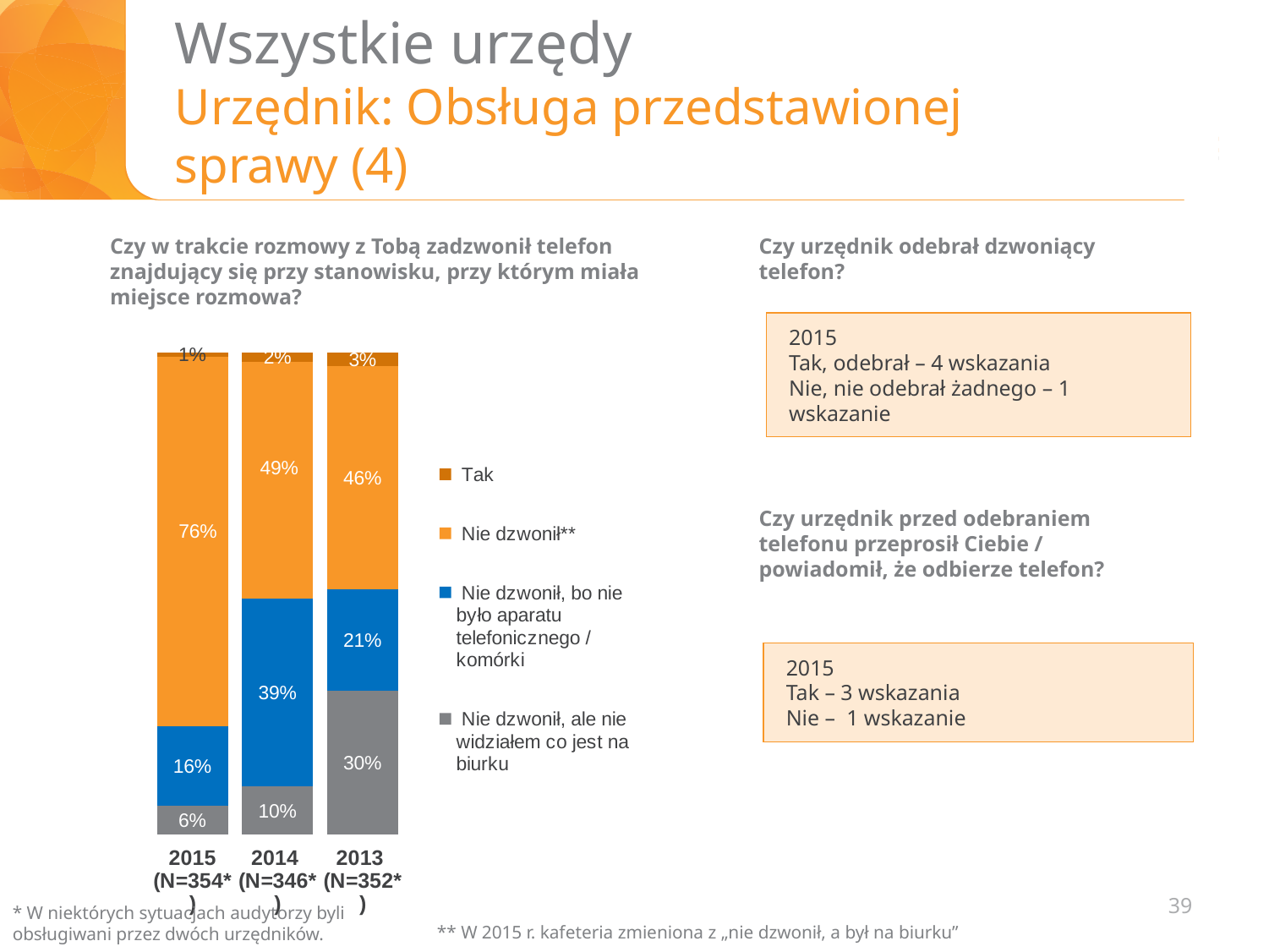
What is the value of "Tak" for 2013? 3% What type of chart is shown on the slide? stacked bar chart What is the sample size (N) shown for the 2014 bar? N=346* What is the value of "Nie dzwonił, ale nie widziałem co jest na biurku" for 2013? 30% What is the difference between the "Nie dzwonił**" values for 2015 and 2014? 27% How many bars (years) are shown in the chart? 3 Which year has the highest value for "Nie dzwonił**"? 2015 What is the value of "Nie dzwonił, bo nie było aparatu telefonicznego / komórki" for 2014? 39% What is the value of "Nie dzwonił**" for 2015? 76% Which year has the lowest value for "Nie dzwonił, ale nie widziałem co jest na biurku"? 2015 Which is larger: the "Nie dzwonił, bo nie było aparatu telefonicznego / komórki" value for 2013 or for 2014? 2014 How many series does the chart legend list? 4